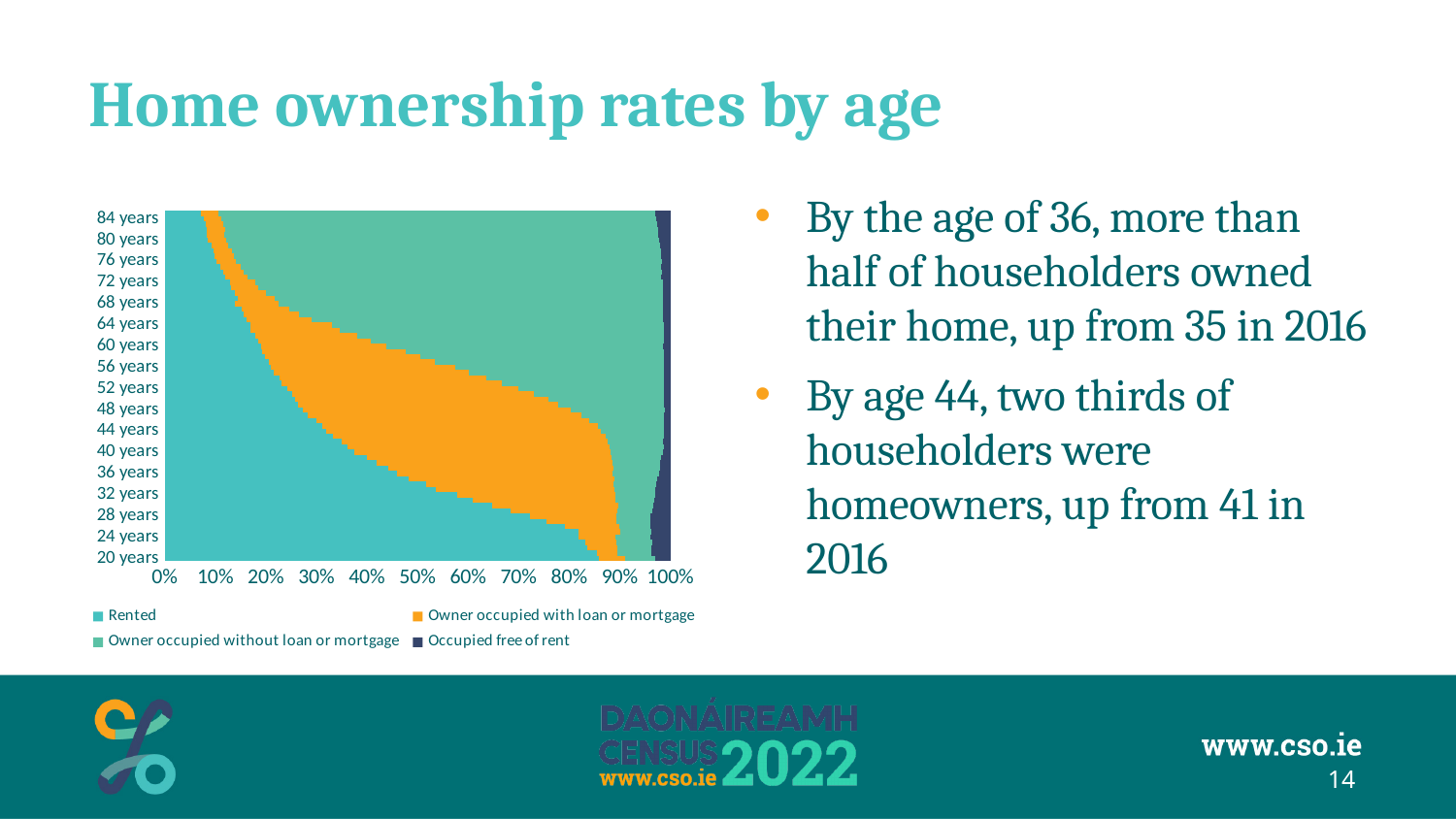
At 20 years, which is larger: the share Rented or the share Owner occupied with loan or mortgage? Rented Does the share of Owner occupied without loan or mortgage rise or fall as age increases from 20 years to 84 years? Rise How many age labels are shown on the vertical axis of the chart? 17 Is the share of Rented households at 20 years greater or less than 50%? greater At 84 years, which series has the largest share? Owner occupied without loan or mortgage What kind of chart is shown on the slide? Stacked bar chart Is the share of Rented households at 84 years greater or less than 20%? less Which series is shown in orange in the chart? Owner occupied with loan or mortgage Is the share of Owner occupied without loan or mortgage at 84 years greater or less than 50%? greater Does the share of Rented households rise or fall as age increases from 20 years to 84 years? Fall What is the title of the chart on the slide? Home ownership rates by age How many series does the legend list? 4